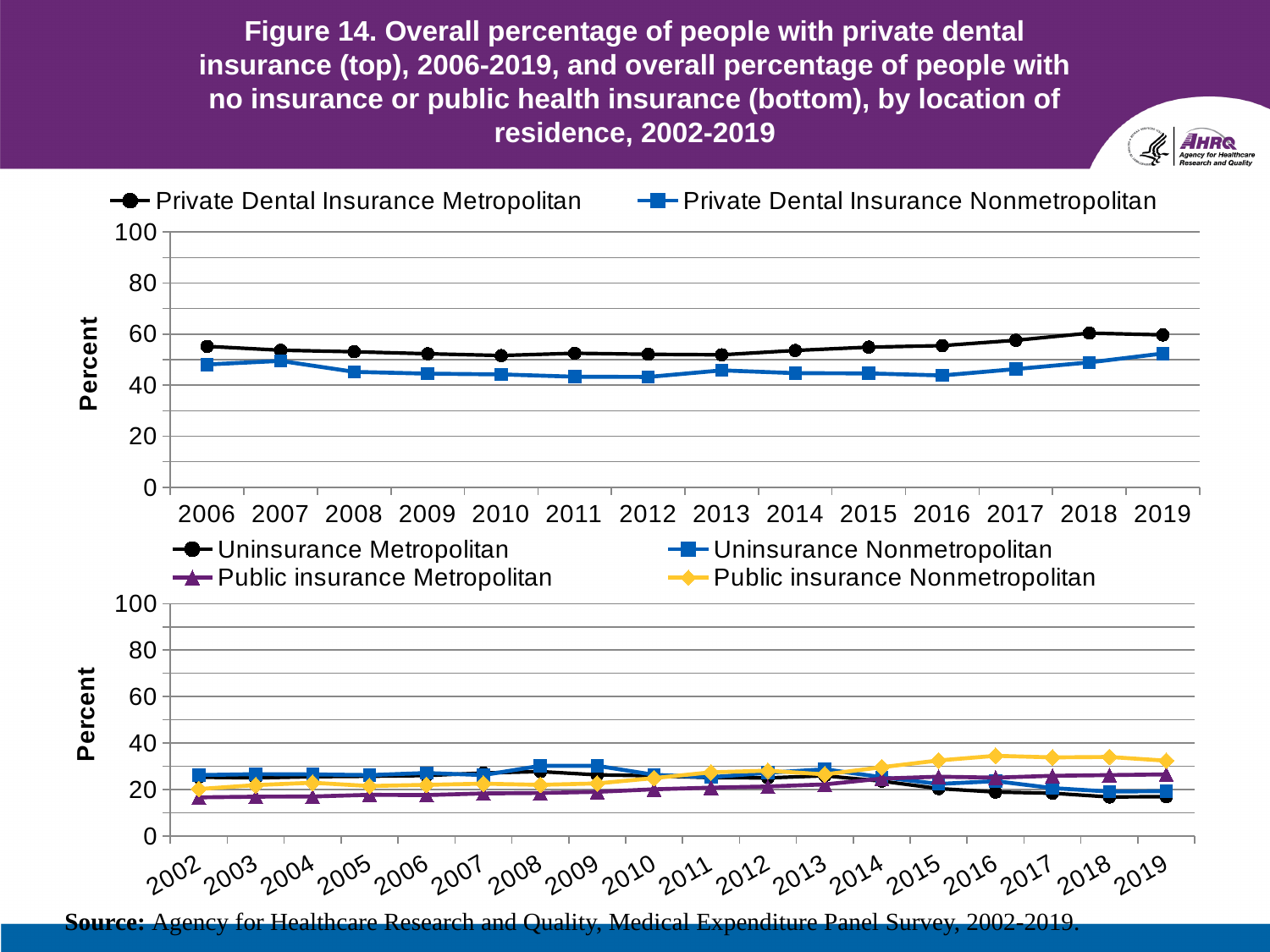
How many series does the legend of the top chart (private dental insurance) list? 2 How many years are plotted along the x axis of the top chart (private dental insurance)? 14 How many series does the legend of the bottom chart (uninsurance and public insurance) list? 4 In the top chart (private dental insurance), is the value for Private Dental Insurance Nonmetropolitan in 2011 greater or less than 60? less In the bottom chart (uninsurance and public insurance), which is higher in 2002: Uninsurance Metropolitan or Public insurance Metropolitan? Uninsurance Metropolitan How many years are plotted along the x axis of the bottom chart (uninsurance and public insurance)? 18 What kind of chart is the top chart showing private dental insurance? Line chart In the top chart (private dental insurance), is the value for Private Dental Insurance Metropolitan in 2018 greater or less than 40? greater What is the label on the vertical axis of the top chart? Percent In the bottom chart (uninsurance and public insurance), does the Uninsurance Metropolitan line rise or fall from 2014 to 2019? Fall In the top chart (private dental insurance), which series is higher in 2006: Metropolitan or Nonmetropolitan? Private Dental Insurance Metropolitan In the bottom chart (uninsurance and public insurance), is the value for Public insurance Nonmetropolitan in 2016 greater or less than 20? greater